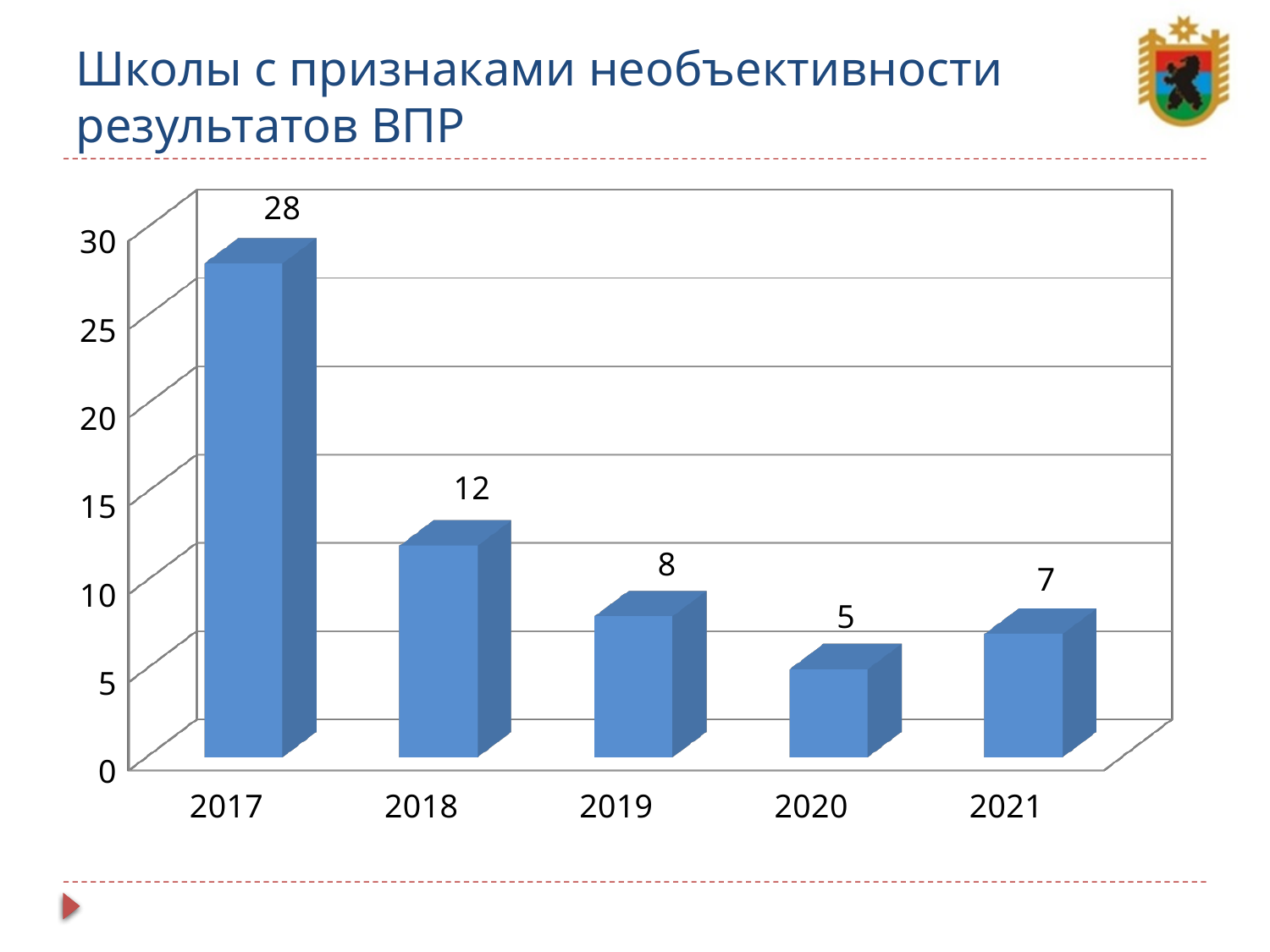
Which year has the lowest value? 2020 Is the value for 2018 greater or less than 10? greater What is the value for 2017? 28 What is the difference between the values for 2017 and 2018? 16 What is the value for 2020? 5 What is the title of the slide? Школы с признаками необъективности результатов ВПР What is the value for 2018? 12 What kind of chart is shown on the slide? bar chart What is the value for 2021? 7 Which is larger, the value for 2019 or the value for 2021? 2019 How many years are shown on the x axis? 5 Which year has the highest value? 2017